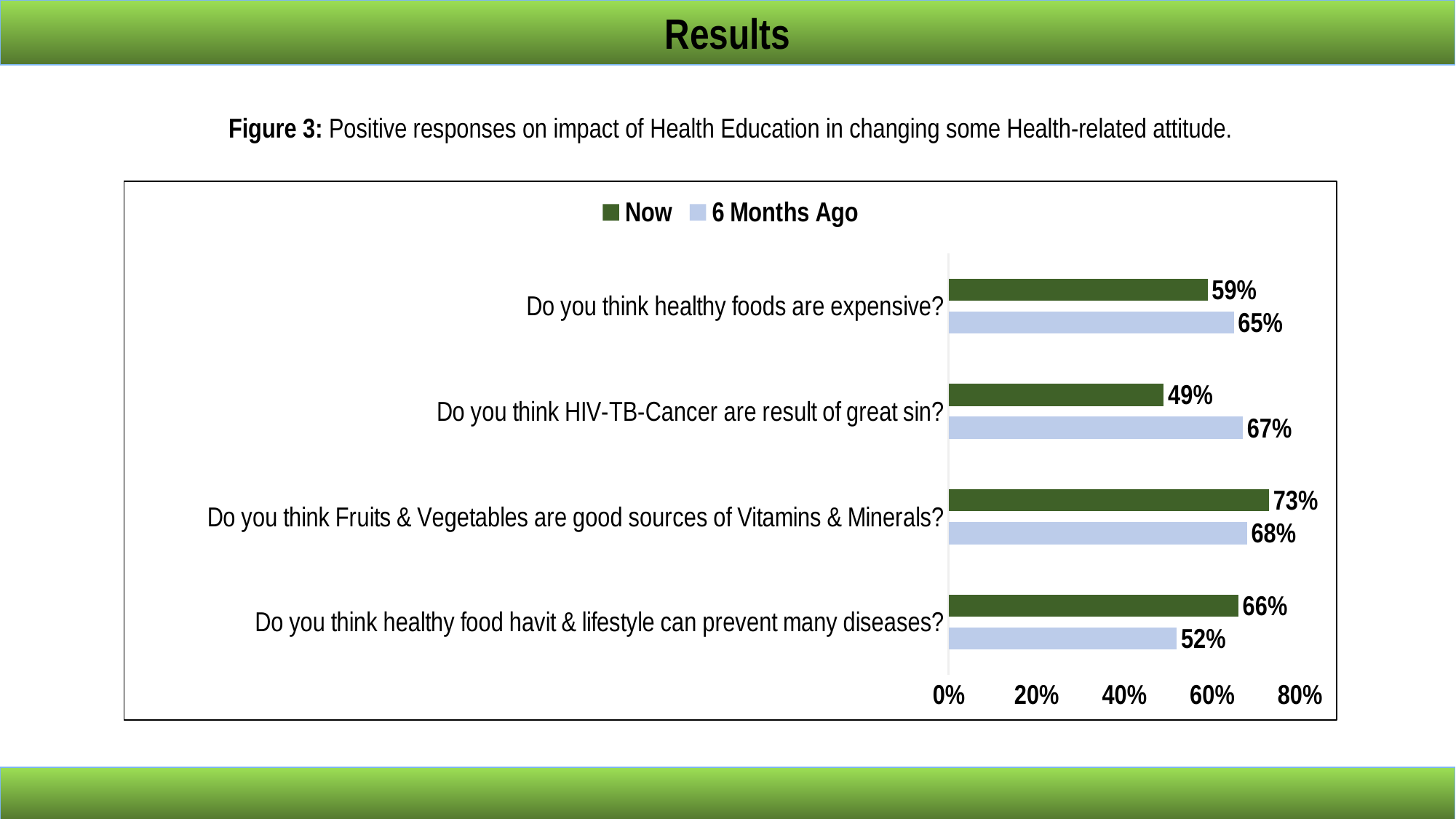
How many questions (categories) are shown on the chart? 4 How many series does the legend list? 2 What is the '6 Months Ago' value for 'Do you think healthy food havit & lifestyle can prevent many diseases?' 52% Which question has the lowest '6 Months Ago' value? Do you think healthy food havit & lifestyle can prevent many diseases? Which question has the lowest 'Now' value? Do you think HIV-TB-Cancer are result of great sin? What is the 'Now' value for 'Do you think Fruits & Vegetables are good sources of Vitamins & Minerals?' 73% What is the difference between the '6 Months Ago' and 'Now' values for 'Do you think HIV-TB-Cancer are result of great sin?' 18% For 'Do you think healthy food havit & lifestyle can prevent many diseases?', which is larger: the 'Now' value or the '6 Months Ago' value? Now Which question has the highest 'Now' value? Do you think Fruits & Vegetables are good sources of Vitamins & Minerals? What is the 'Now' value for 'Do you think healthy foods are expensive?' 59% What kind of chart is shown on the slide? Bar chart What is the '6 Months Ago' value for 'Do you think HIV-TB-Cancer are result of great sin?' 67%